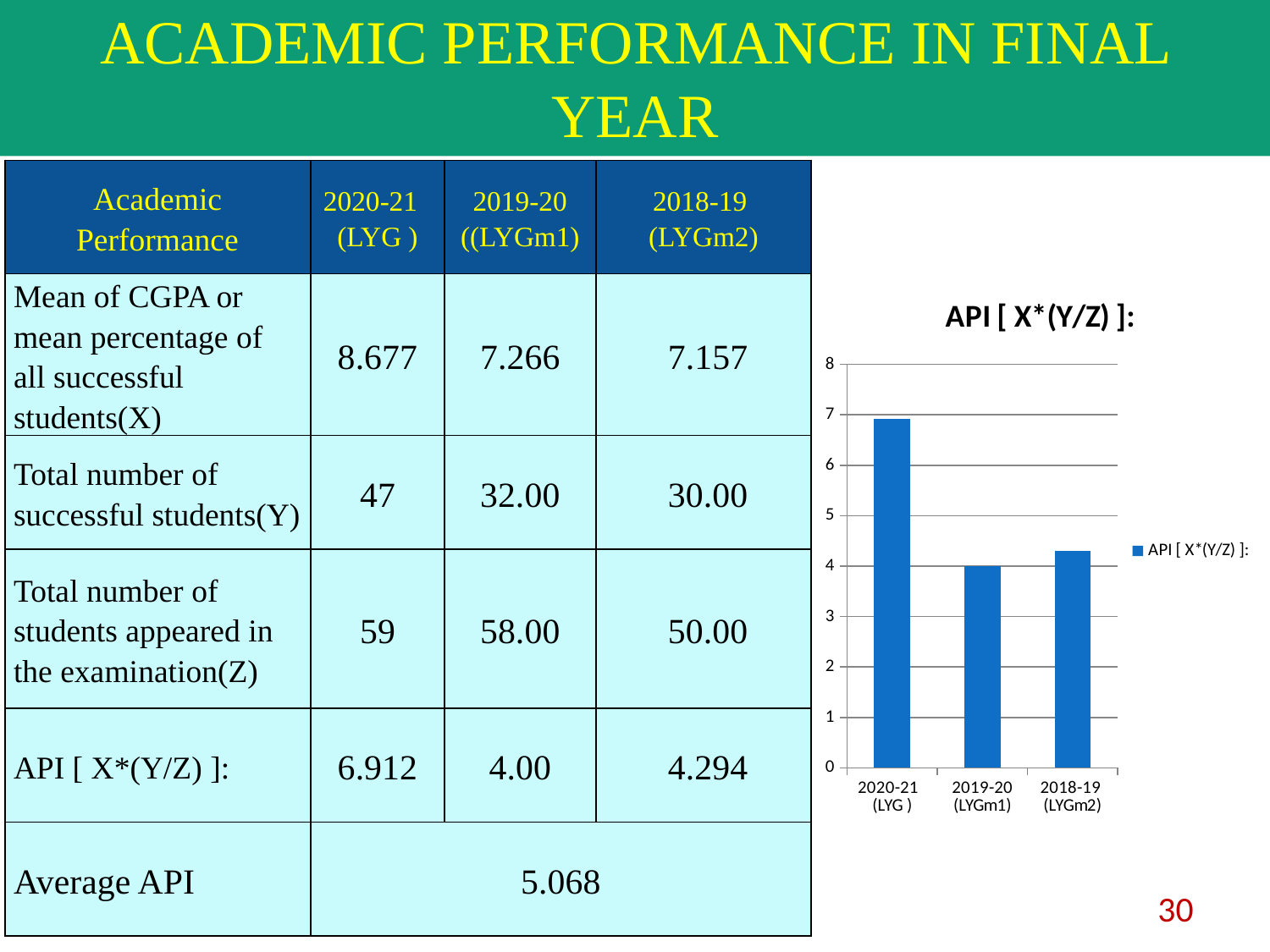
Is the API value for 2018-19 (LYGm2) greater or less than 5? less Which year has the highest API value in the chart? 2020-21 (LYG ) How many series does the chart legend list? 1 What is the API value for 2018-19 (LYGm2)? 4.294 What is the API value for 2020-21 (LYG )? 6.912 How many bars does the chart have? 3 What is the title of the chart? API [ X*(Y/Z) ]: What is the API value for 2019-20 (LYGm1)? 4.00 Is the API value for 2020-21 (LYG ) greater or less than 6? greater Which year has the lowest API value in the chart? 2019-20 (LYGm1) Which is larger, the API value for 2020-21 (LYG ) or for 2018-19 (LYGm2)? 2020-21 (LYG ) What kind of chart is shown on the slide? bar chart